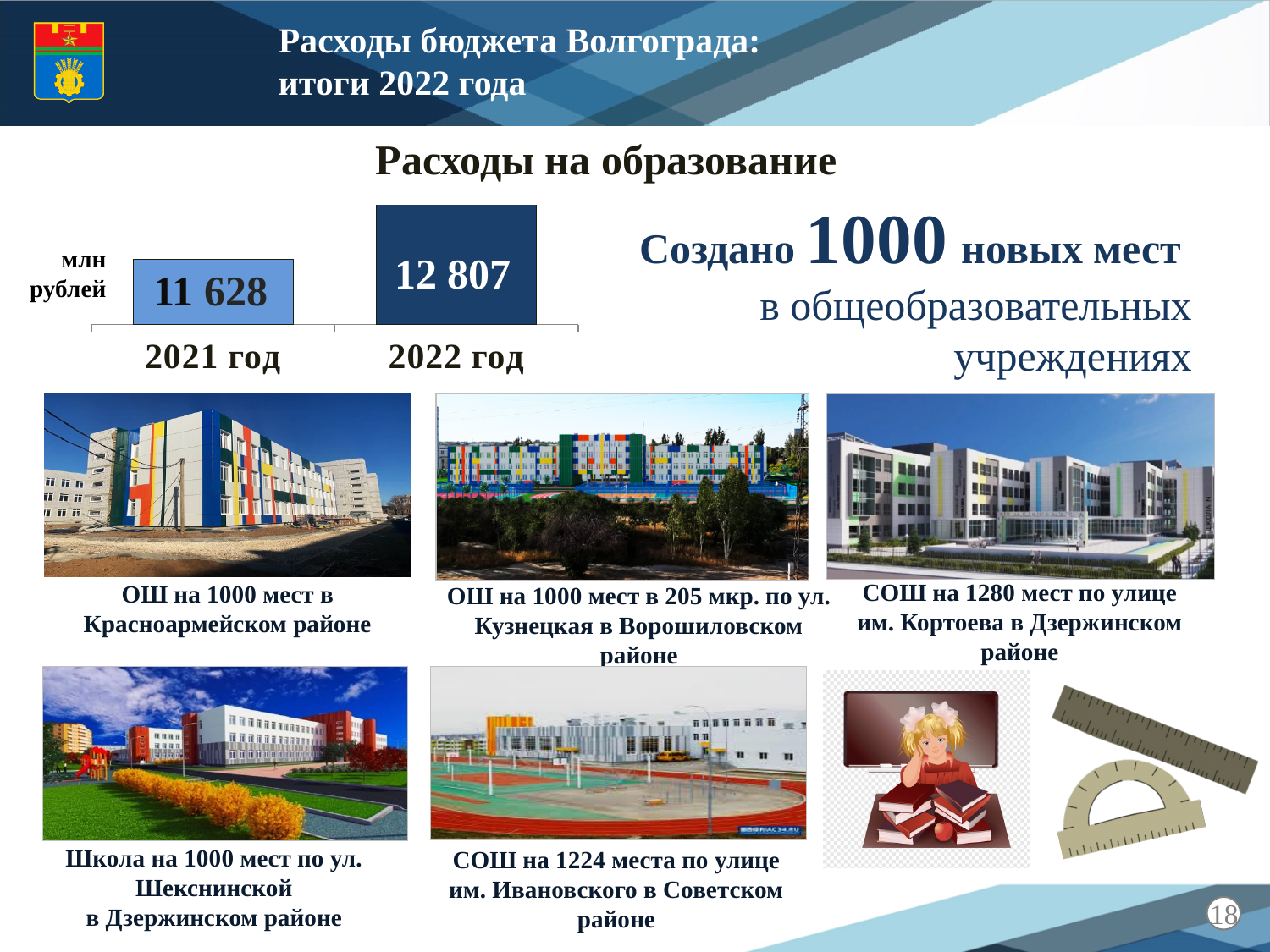
What is the value for 2022 год in the bar chart? 12 807 Which year has the lower value in the bar chart? 2021 год What kind of chart is shown on the slide? bar chart What is the difference between the 2022 год and 2021 год values in the bar chart? 1 179 Which year has the higher value in the bar chart? 2022 год Is the value for 2022 год larger or smaller than the value for 2021 год? larger What is the value for 2021 год in the bar chart? 11 628 How many bars are shown in the chart? 2 What is the title above the bar chart? Расходы на образование Do the values rise or fall from 2021 год to 2022 год? rise What unit is indicated for the values in the bar chart? млн рублей